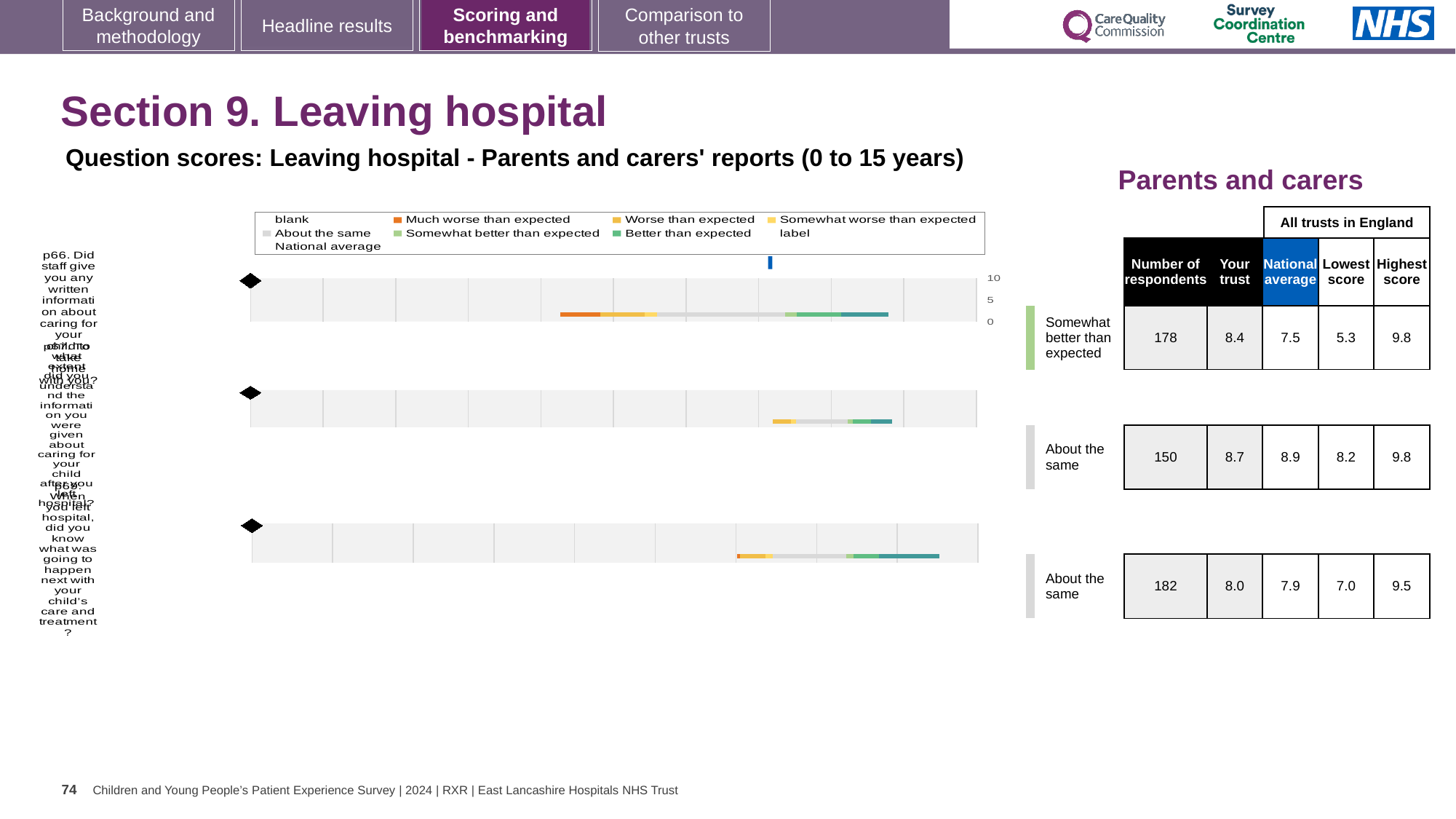
Which question has the lowest 'Lowest score' across all trusts in England? the third question (7.0) How many questions (bars) are plotted in the chart? 3 Which question has the highest 'Your trust' score? the second question (8.7) What kind of chart is shown on the slide? bar chart For the first question (178 respondents), which is larger: the 'Your trust' score or the national average? Your trust What is the title of the chart? Question scores: Leaving hospital - Parents and carers' reports (0 to 15 years) What is the 'Your trust' score for the second question (150 respondents)? 8.7 In the chart legend, what colour represents 'Much worse than expected'? orange How many respondents are shown for the first question (rated 'Somewhat better than expected')? 178 What is the lowest score across all trusts in England for the second question (150 respondents)? 8.2 For the third question (182 respondents), what is the difference between the highest score and the lowest score? 2.5 What is the national average for the third question (182 respondents)? 7.9